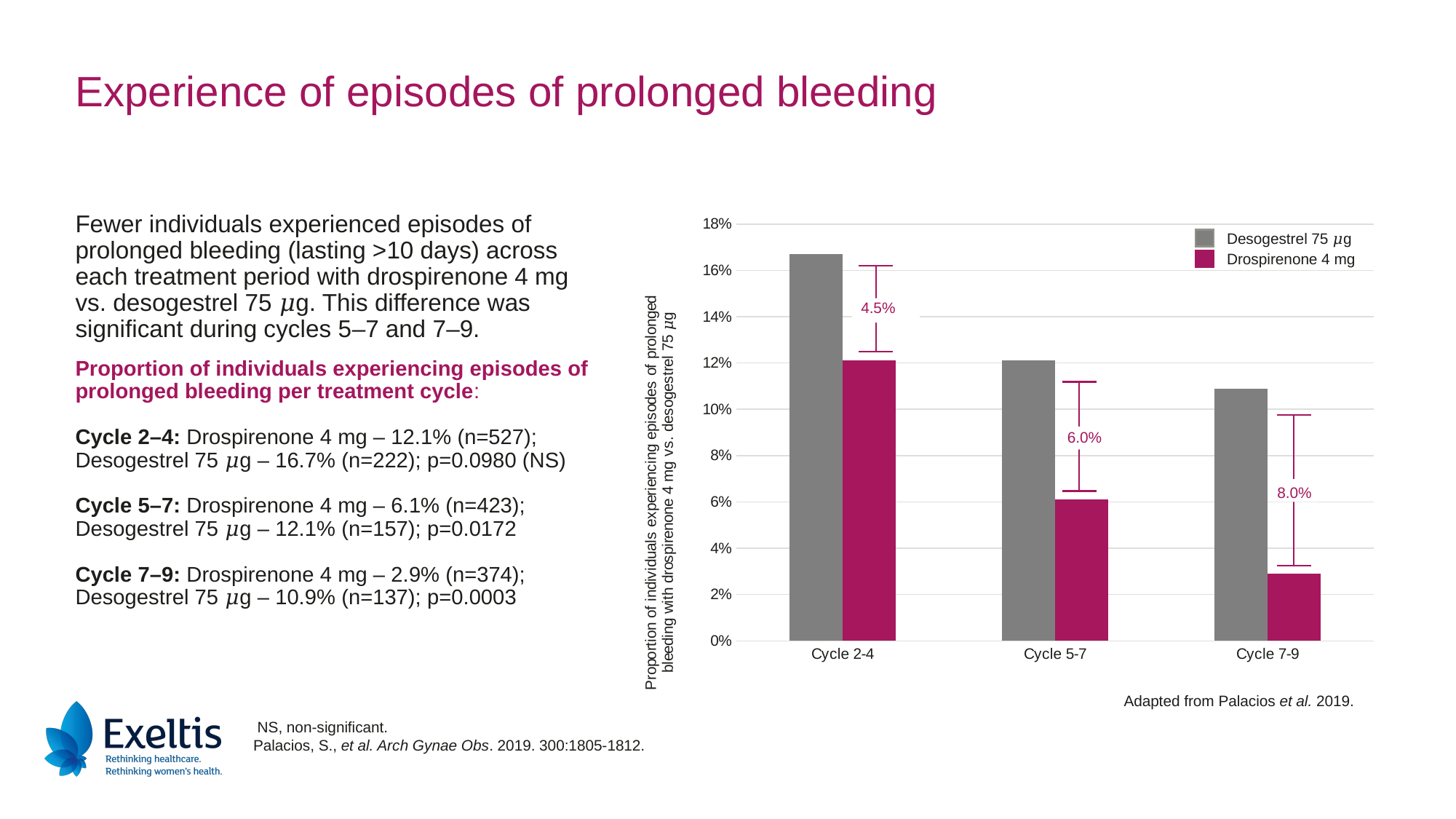
Which bar is the highest in the chart? Desogestrel 75 µg, Cycle 2-4 Is the value for Drospirenone 4 mg in Cycle 7-9 greater or less than 4%? less What kind of chart is shown on the slide? Bar chart How many series does the chart legend list? 2 Is the value for Desogestrel 75 µg in Cycle 2-4 greater or less than 16%? greater Which series is shown in grey in the chart legend? Desogestrel 75 µg How many treatment cycle categories are shown on the x axis? 3 Do the Drospirenone 4 mg values rise or fall from Cycle 2-4 to Cycle 7-9? Fall Which bar is the lowest in the chart? Drospirenone 4 mg, Cycle 7-9 What difference is annotated between the two bars for Cycle 5-7? 6.0% In Cycle 5-7, which series has the larger value, Desogestrel 75 µg or Drospirenone 4 mg? Desogestrel 75 µg What difference is annotated between the two bars for Cycle 7-9? 8.0%